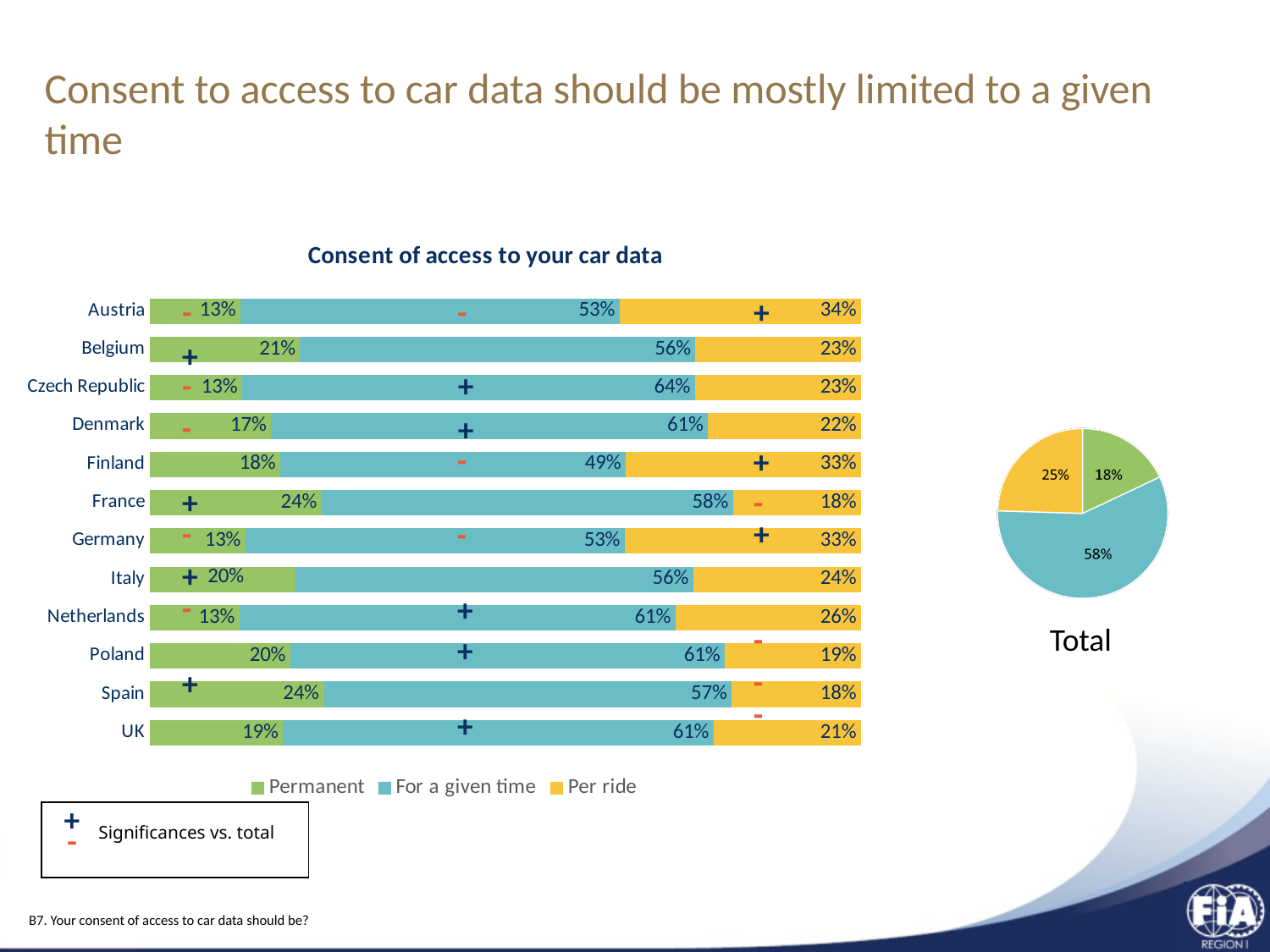
In the 'Consent of access to your car data' bar chart, which country has the lowest 'For a given time' value? Finland In the 'Total' pie chart, what share does the largest slice represent? 58% In the 'Consent of access to your car data' bar chart, which country has the highest 'For a given time' value? Czech Republic What kind of chart is the 'Consent of access to your car data' chart? Stacked bar chart In the 'Consent of access to your car data' bar chart, which is larger: the 'Permanent' value for Belgium or the 'Permanent' value for Denmark? Belgium How many series does the legend of the 'Consent of access to your car data' chart list? 3 In the 'Consent of access to your car data' bar chart, which country has the highest 'Per ride' value? Austria In the 'Consent of access to your car data' bar chart, what is the 'For a given time' value for Czech Republic? 64% In the 'Consent of access to your car data' bar chart, what percentage of respondents in Austria chose 'Per ride'? 34% How many countries are shown in the 'Consent of access to your car data' bar chart? 12 In the 'Consent of access to your car data' bar chart, what is the difference between the 'For a given time' values for Czech Republic and Finland? 15 percentage points In the 'Consent of access to your car data' bar chart, what is the 'Permanent' value for France? 24%